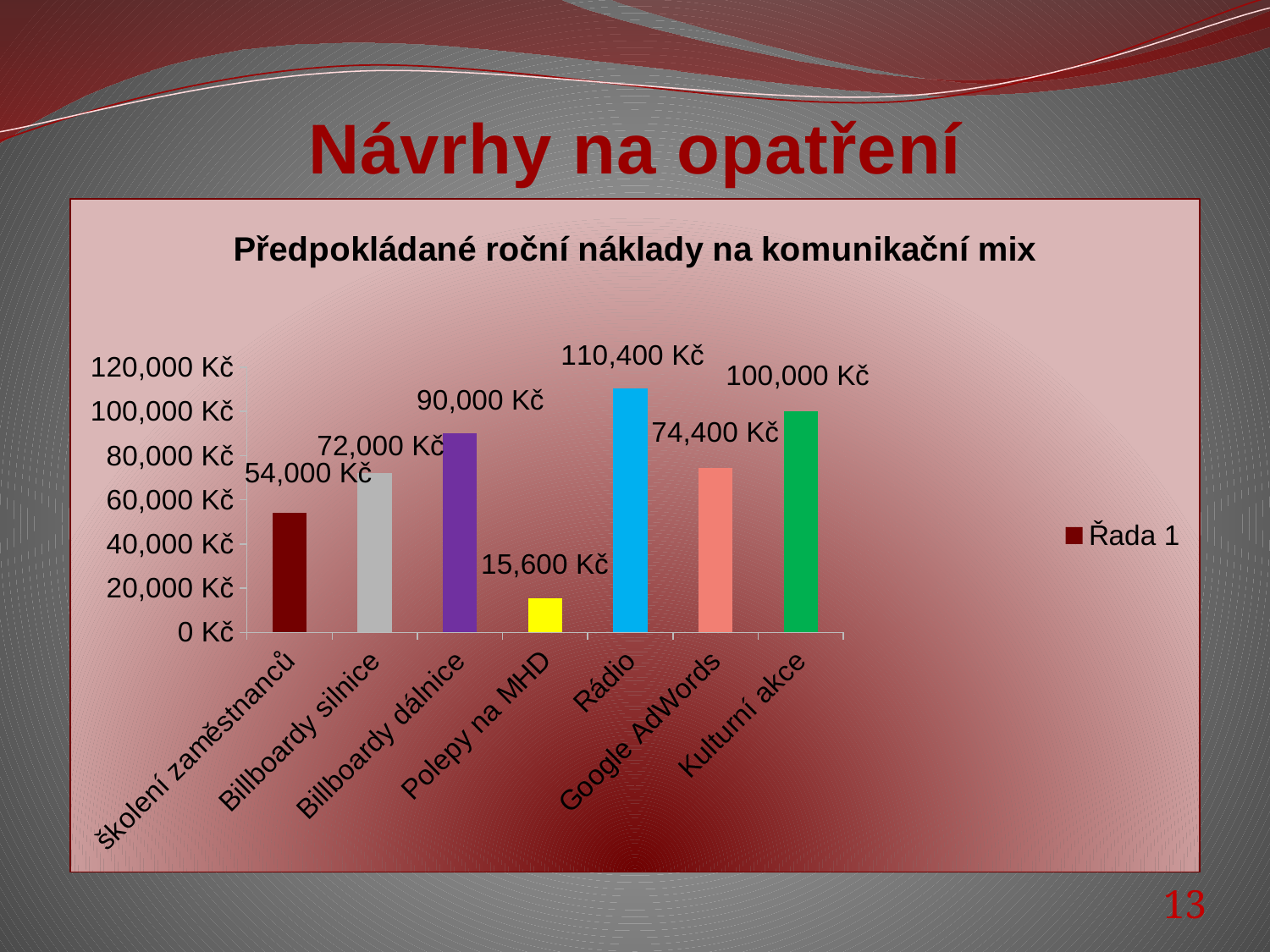
How many categories are shown on the x axis? 7 How many series does the legend list? 1 Which is larger, the value for Kulturní akce or the value for Google AdWords? Kulturní akce Which category has the highest value? Rádio What kind of chart is shown? bar chart What is the title of the chart? Předpokládané roční náklady na komunikační mix Is the value for školení zaměstnanců greater or less than 60,000 Kč? less What is the value for Rádio? 110,400 Kč What is the difference between the values for Billboardy dálnice and Billboardy silnice? 18,000 Kč What is the value for Google AdWords? 74,400 Kč What is the value for Polepy na MHD? 15,600 Kč Which category has the lowest value? Polepy na MHD